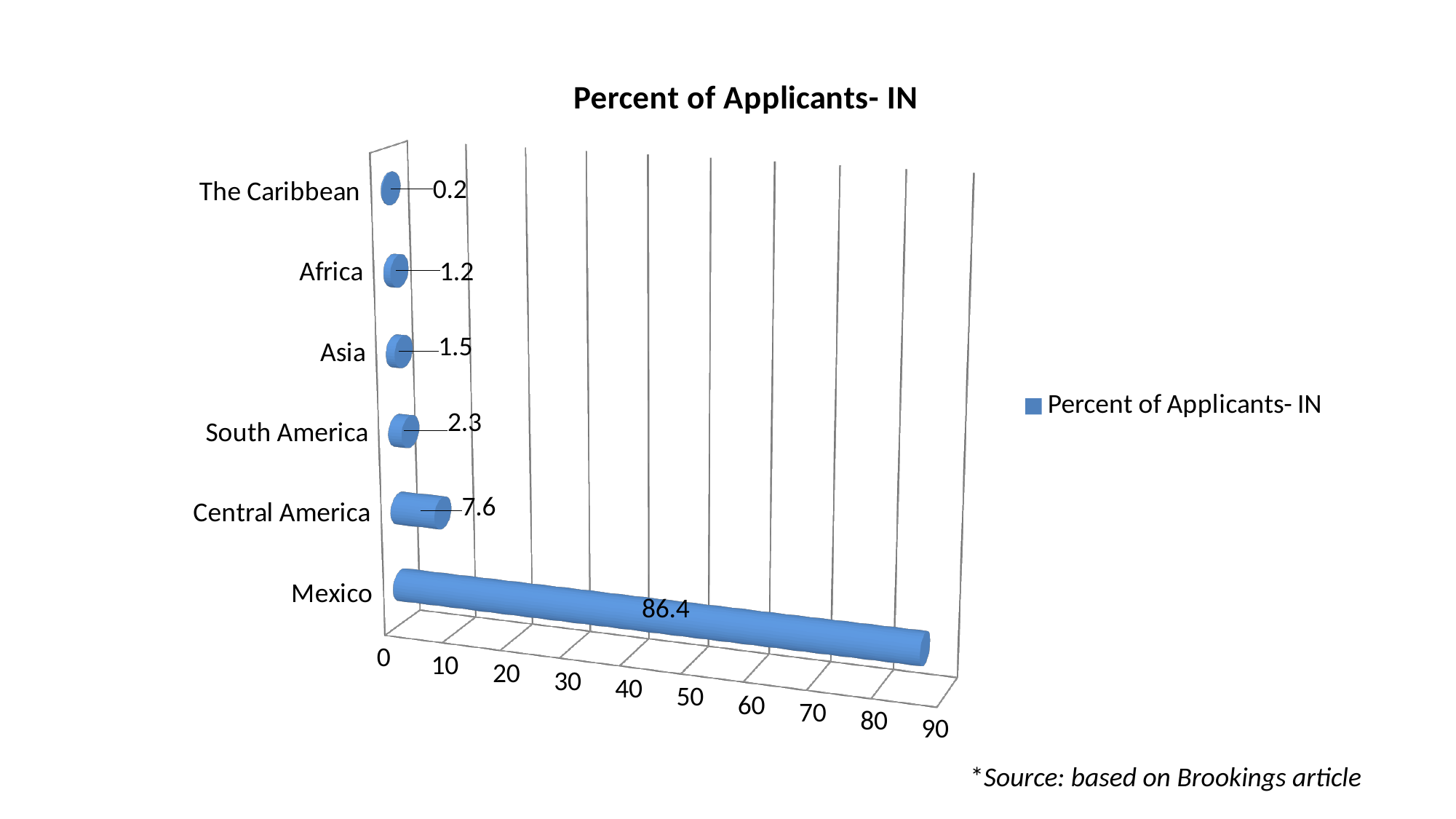
Which is larger, the value for South America or the value for Asia? South America What is the value for South America? 2.3 What is the value for Central America? 7.6 What is the value for Mexico? 86.4 Which category has the highest value? Mexico What is the title of the chart? Percent of Applicants- IN What kind of chart is shown on the slide? Bar chart How many categories are shown on the chart? 6 What is the value for Asia? 1.5 What is the difference between the values for Mexico and Central America? 78.8 Which category has the lowest value? The Caribbean What is the value for Africa? 1.2